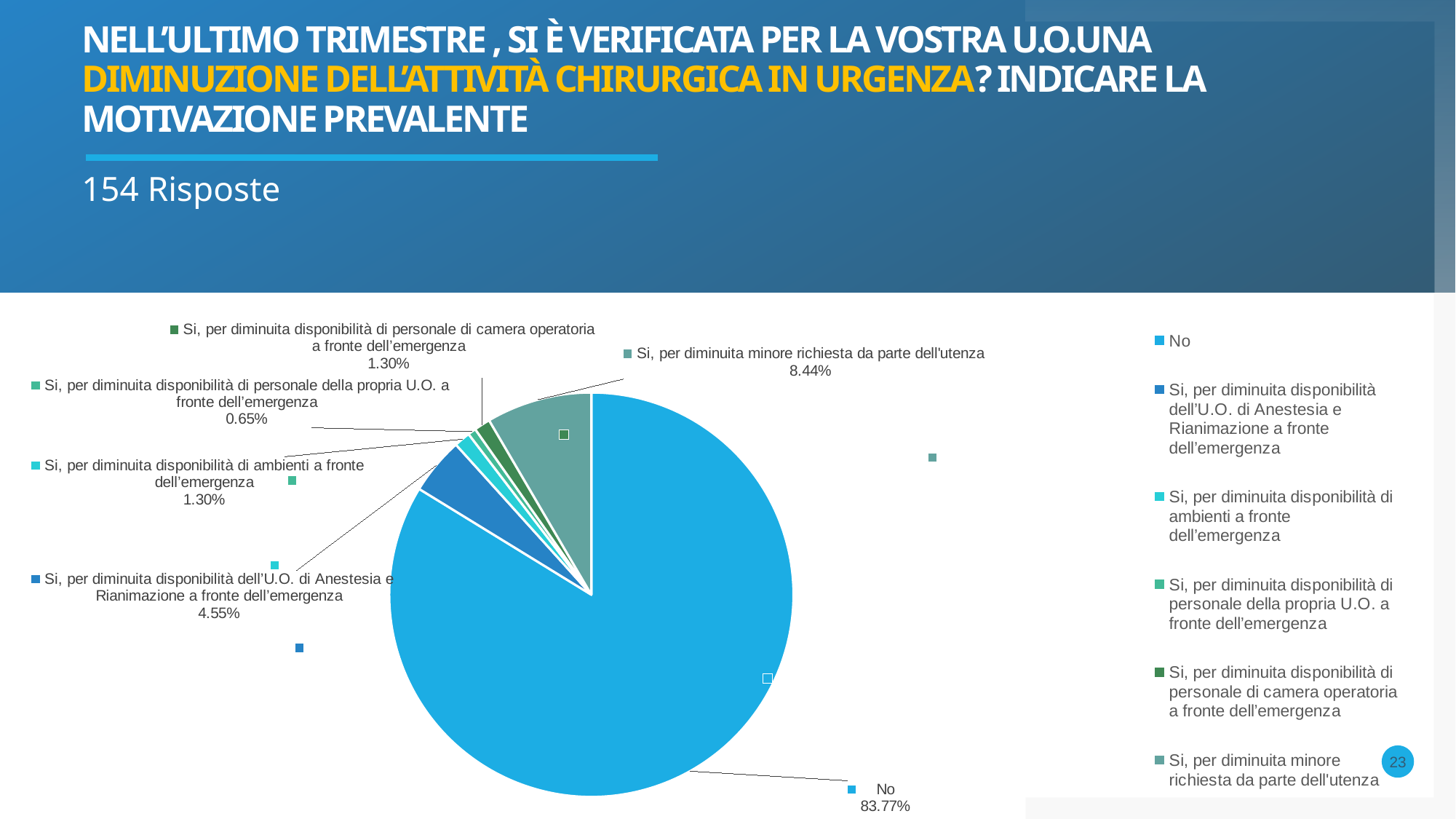
How many categories does the pie chart have? 6 What share of responses is "Si, per diminuita disponibilità di ambienti a fronte dell'emergenza"? 1.30% Which is larger: the share for "Si, per diminuita minore richiesta da parte dell'utenza" or for "Si, per diminuita disponibilità dell'U.O. di Anestesia e Rianimazione a fronte dell'emergenza"? Si, per diminuita minore richiesta da parte dell'utenza Which category has the largest slice of the pie? No What share of responses is "Si, per diminuita disponibilità di personale della propria U.O. a fronte dell'emergenza"? 0.65% What share of responses is "No"? 83.77% Which category has the smallest slice of the pie? Si, per diminuita disponibilità di personale della propria U.O. a fronte dell'emergenza What kind of chart is shown on the slide? Pie chart What share of responses is "Si, per diminuita minore richiesta da parte dell'utenza"? 8.44% What share of responses is "Si, per diminuita disponibilità dell'U.O. di Anestesia e Rianimazione a fronte dell'emergenza"? 4.55% How many responses does the slide say the chart is based on? 154 What is the difference in percentage points between "No" and "Si, per diminuita minore richiesta da parte dell'utenza"? 75.33